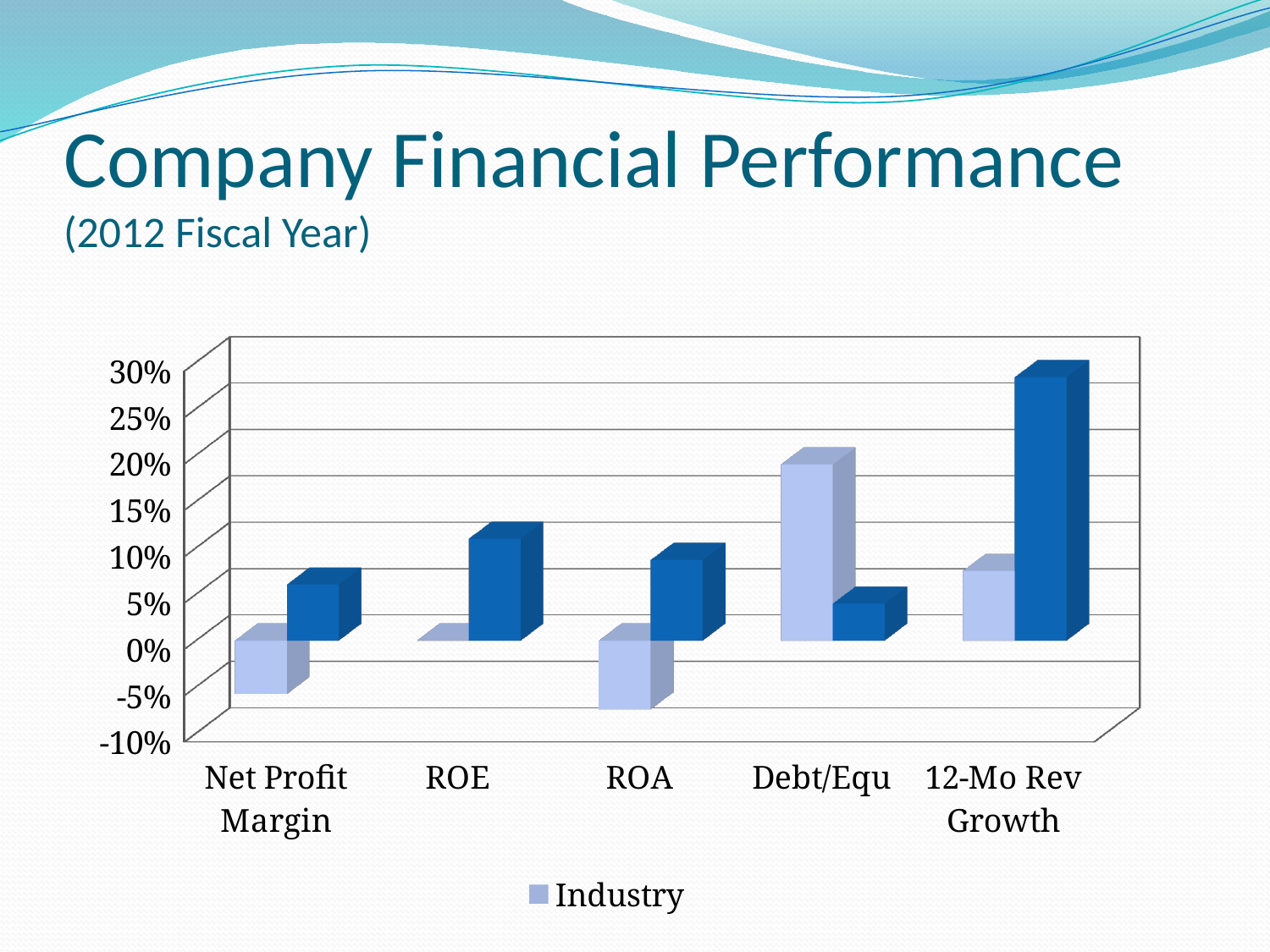
Which series name appears in the chart's legend? Industry Is the Industry value for Net Profit Margin greater or less than 0%? less Is the Industry value for Debt/Equ greater or less than 15%? greater For 12-Mo Rev Growth, which is larger: the Industry bar or the dark blue bar? The dark blue bar What kind of chart is shown on the slide? Bar chart How many categories are shown on the x axis of the chart? 5 For Debt/Equ, which is larger: the Industry bar or the dark blue bar? Industry Is the Industry value for ROA greater or less than 0%? less Which category has the highest value for the dark blue series? 12-Mo Rev Growth Which category has the highest Industry value? Debt/Equ How many series does the chart's legend list? 1